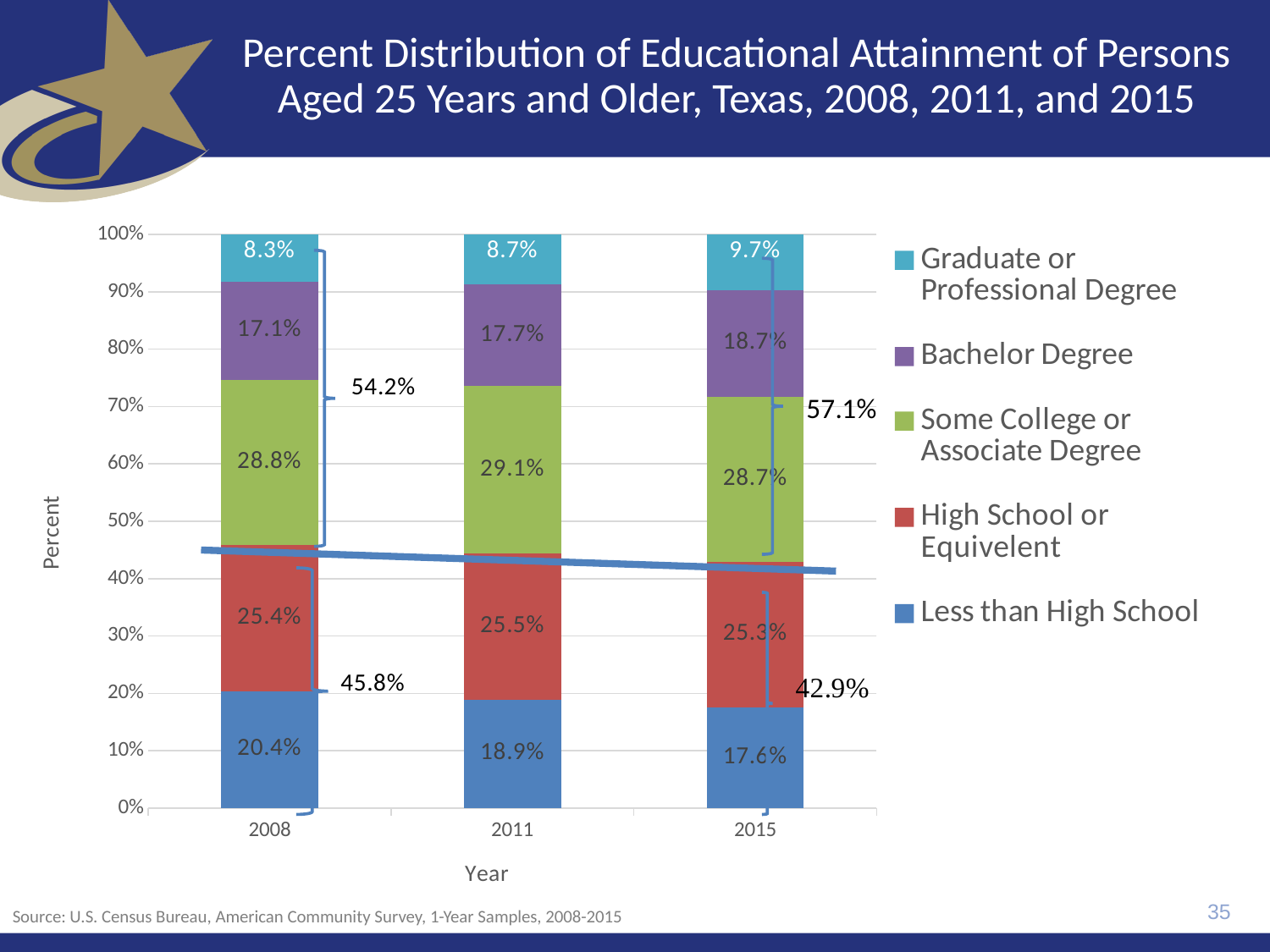
By how many percentage points did the Bachelor Degree share change from 2008 to 2015? 1.6 percentage points What kind of chart is shown on the slide? Stacked bar chart What is the value for Bachelor Degree in 2011? 17.7% What percentage of persons aged 25 and older in Texas had less than a high school education in 2008? 20.4% In which year is the Graduate or Professional Degree share the highest? 2015 In which year is the Less than High School share the lowest? 2015 What is the combined share of Less than High School and High School or Equivelent in 2015? 42.9% How many educational attainment categories does the legend list? 5 How many years are shown on the x axis? 3 Which year has the larger Some College or Associate Degree share, 2011 or 2015? 2011 What is the value for Graduate or Professional Degree in 2015? 9.7% Does the Less than High School share rise or fall from 2008 to 2015? Fall